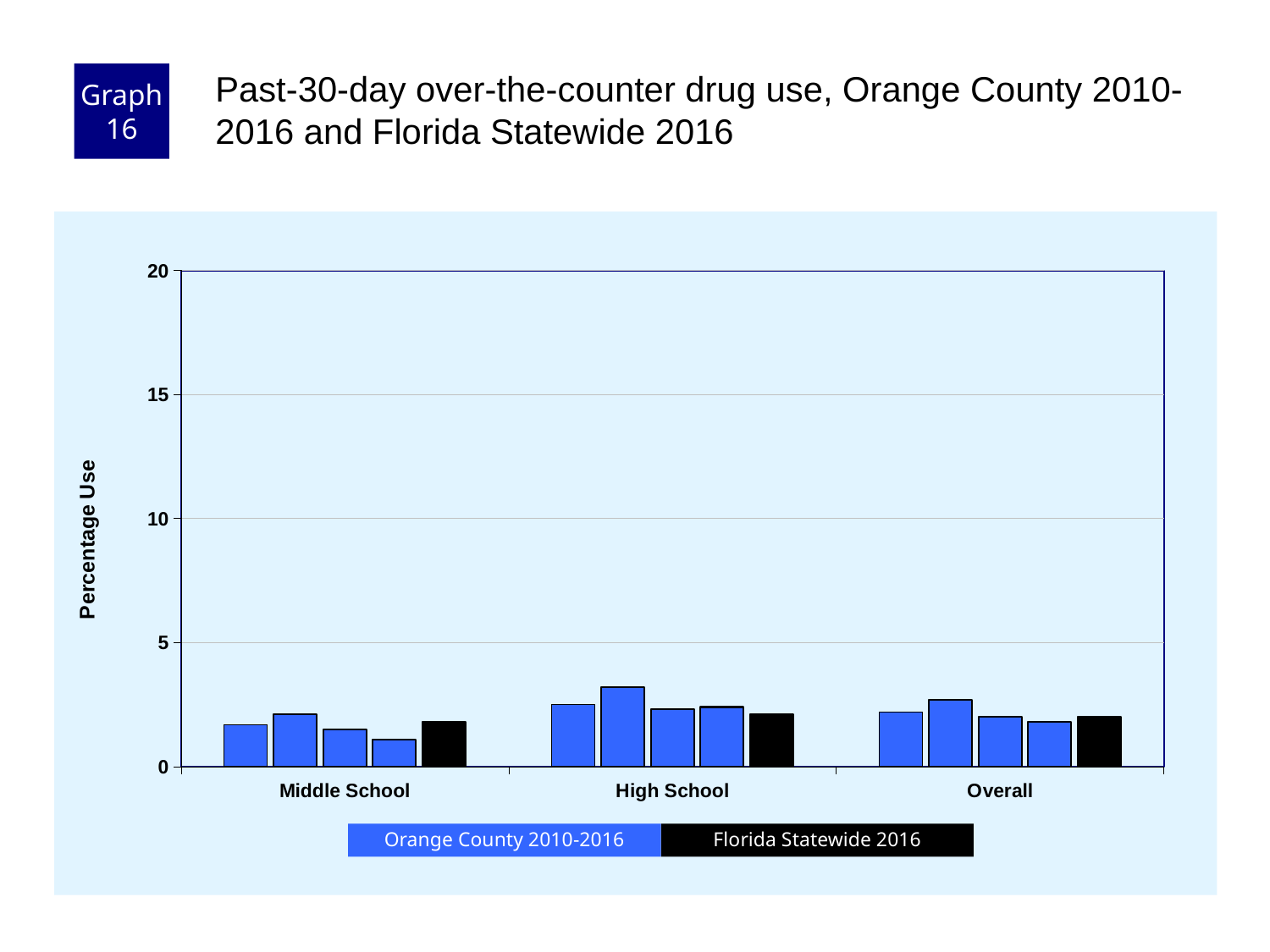
What colour are the Florida Statewide 2016 bars? black Which is larger: the Florida Statewide 2016 bar for High School or the Florida Statewide 2016 bar for Middle School? High School Is the tallest Orange County 2010-2016 bar for High School greater or less than 5? less How many categories are shown along the x axis? 3 Which category group contains the tallest bar? High School Is the Florida Statewide 2016 value for Overall greater or less than 10? less Is the Florida Statewide 2016 value for Middle School greater or less than 5? less What kind of chart is shown on the slide? bar chart Which is larger: the tallest Orange County 2010-2016 bar for High School or the tallest Orange County 2010-2016 bar for Middle School? High School What is the label on the y axis? Percentage Use How many series does the legend list? 2